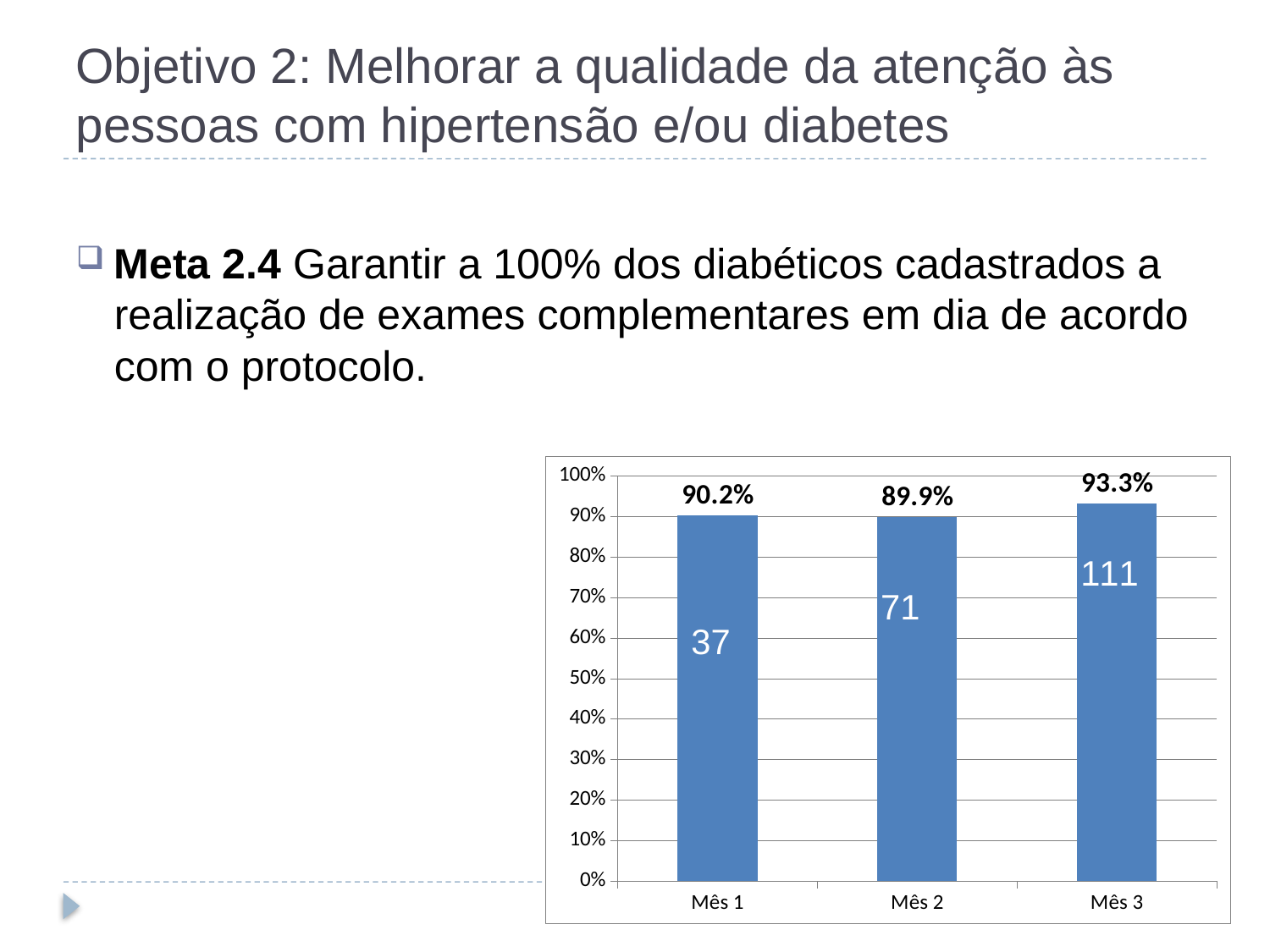
Which month has the lowest percentage? Mês 2 Which month has the highest percentage? Mês 3 Is the value for Mês 2 greater or less than 80%? greater What number is printed inside the bar for Mês 1? 37 What is the difference in percentage points between Mês 3 and Mês 1? 3.1 What is the percentage value shown for Mês 3? 93.3% What is the percentage value shown for Mês 2? 89.9% What kind of chart is shown on the slide? Bar chart What number is printed inside the bar for Mês 3? 111 Which is larger, the percentage for Mês 1 or for Mês 2? Mês 1 What is the percentage value shown for Mês 1? 90.2% How many months are shown on the x axis? 3